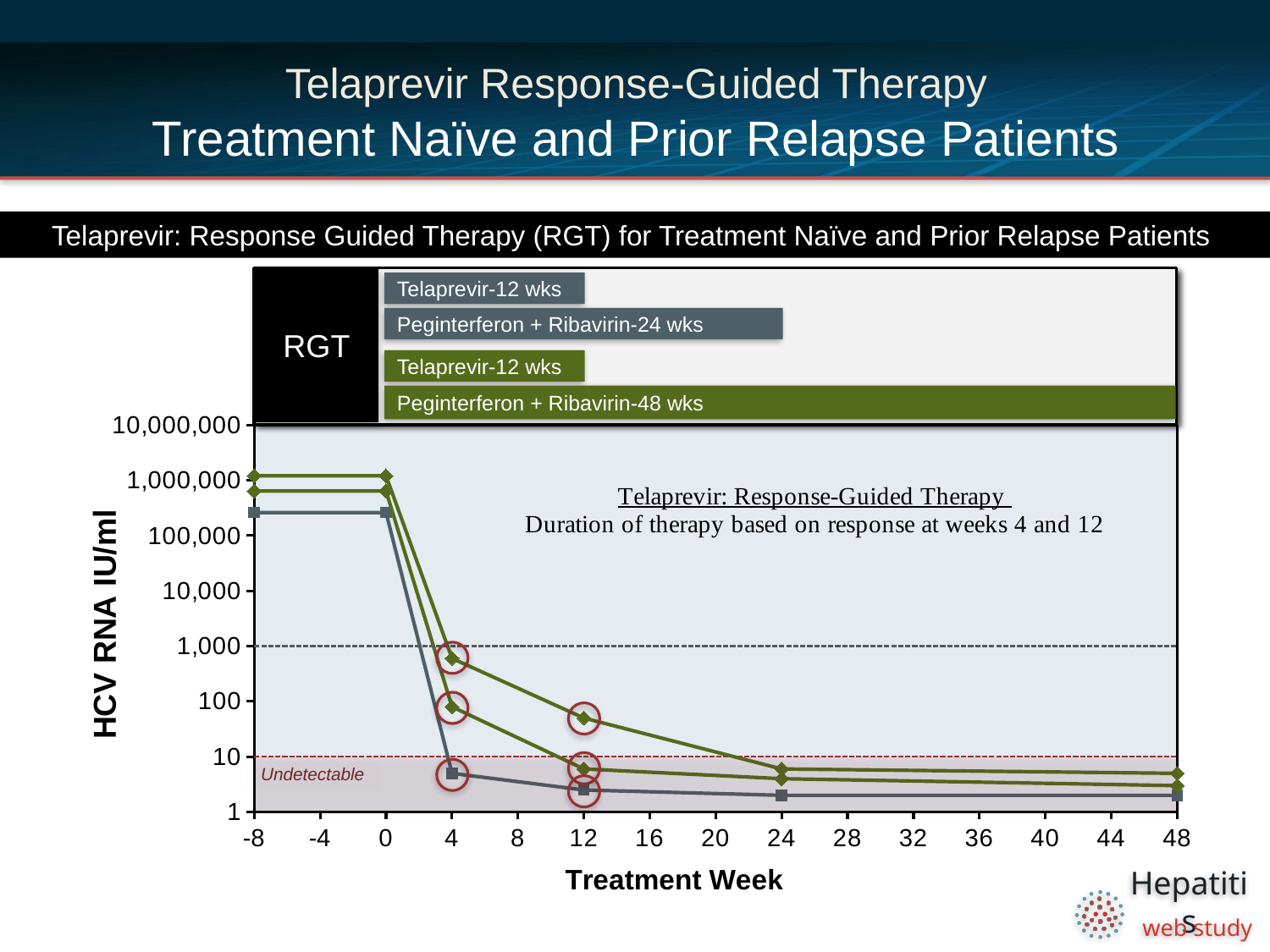
What is the label of the x axis of the chart? Treatment Week Is the value of the gray line at treatment week 4 greater or less than 10? less Is the value of the upper green line at treatment week 4 greater or less than 1,000? less How many tick labels are shown on the x axis? 15 Is the value of the lower green line at treatment week 12 greater or less than 10? less How many lines are plotted on the chart? 3 What is the highest tick value shown on the y axis? 10,000,000 What is the label of the y axis of the chart? HCV RNA IU/ml What kind of chart is shown on the slide? line chart Do the plotted HCV RNA values rise or fall along the x axis after week 0? fall